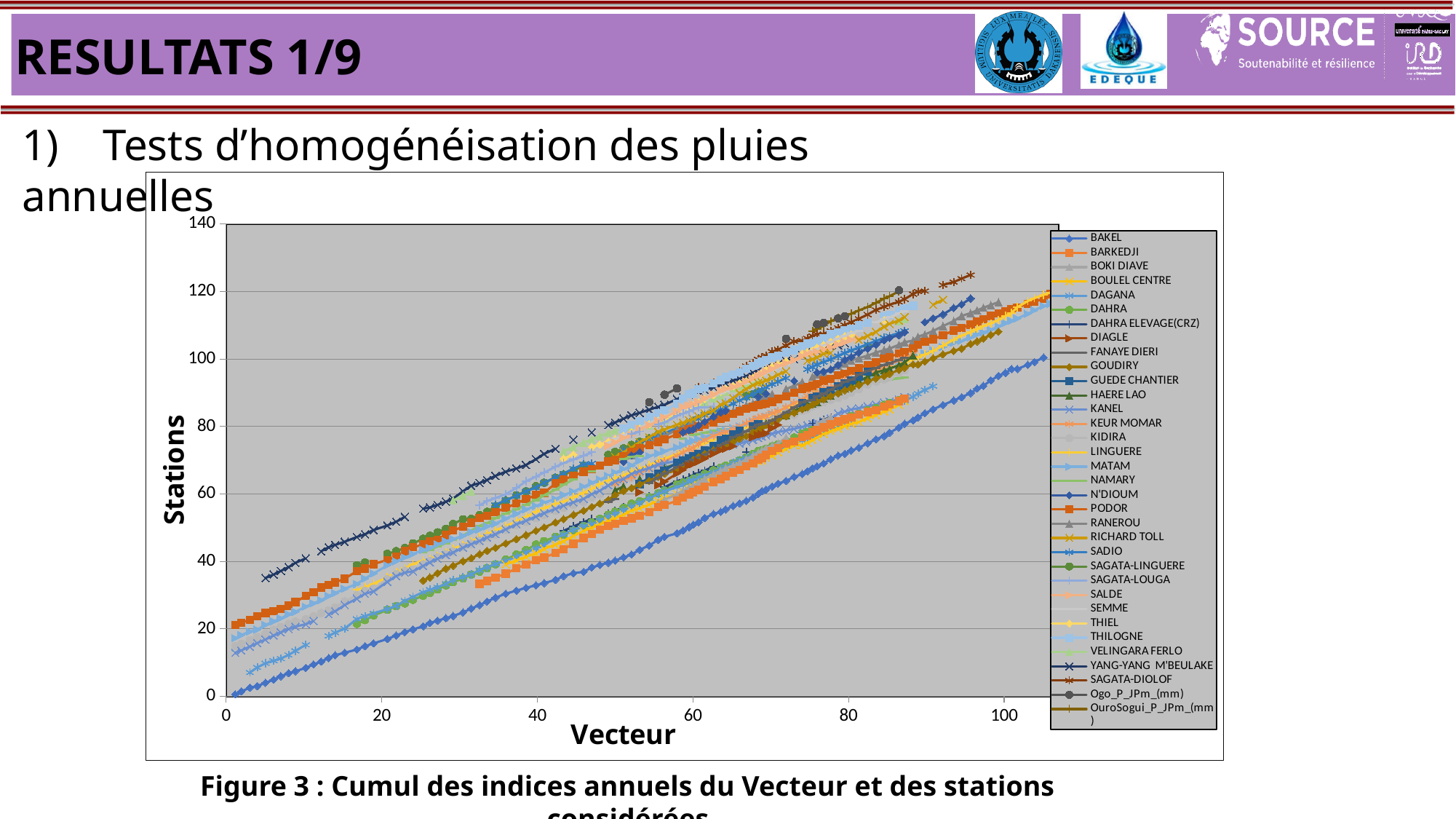
Which series is listed first in the legend? BAKEL How many series does the legend list? 34 What is the figure number given in the caption below the chart? Figure 3 What is the highest tick value shown on the y axis? 140 What is the title of the y axis? Stations Do the plotted values rise or fall as the Vecteur value increases along the x axis? rise What kind of chart is shown on the slide? scatter (line) chart What is the title of the x axis? Vecteur What is the highest tick value shown on the x axis? 100 Which series is listed last in the legend? OuroSogui_P_JPm_(mm)